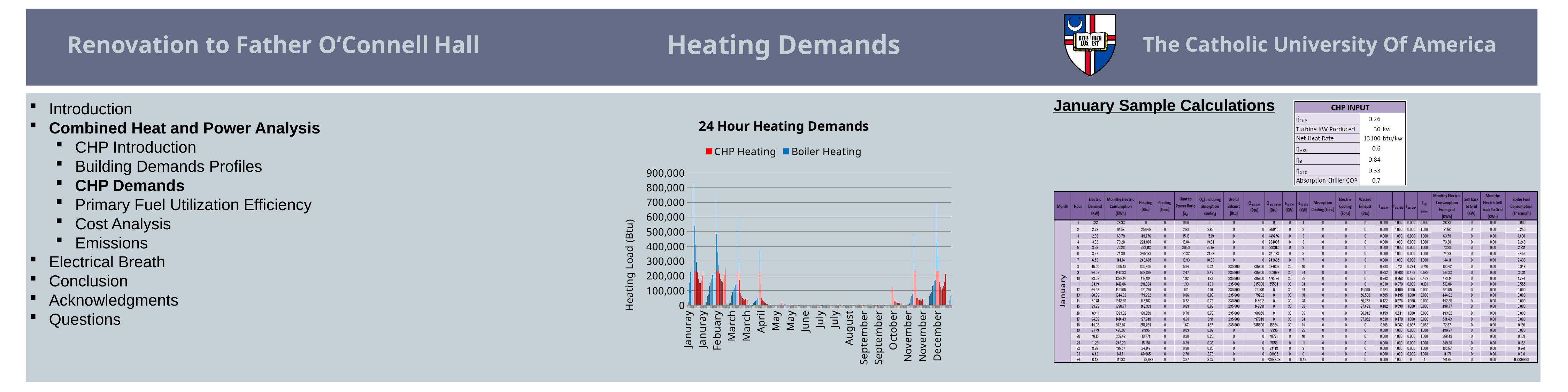
How many series does the legend of the "24 Hour Heating Demands" chart list? 2 In the "24 Hour Heating Demands" chart, which is larger: the tallest bar in January or the tallest bar in June? January In the "24 Hour Heating Demands" chart, is the tallest bar greater or less than 700,000? greater In the "24 Hour Heating Demands" chart, do the heating loads rise or fall from September to December? rise In the "24 Hour Heating Demands" chart, are the heating loads in July greater or less than 100,000? less In the "24 Hour Heating Demands" chart, do the heating loads rise or fall from January toward the summer months? fall What is the label on the vertical axis of the "24 Hour Heating Demands" chart? Heating Load (Btu) What kind of chart is the "24 Hour Heating Demands" chart? bar chart What is the highest tick value shown on the vertical axis of the "24 Hour Heating Demands" chart? 900,000 What are the two series named in the legend of the "24 Hour Heating Demands" chart? CHP Heating and Boiler Heating In the "24 Hour Heating Demands" chart, which month has the tallest bar? January